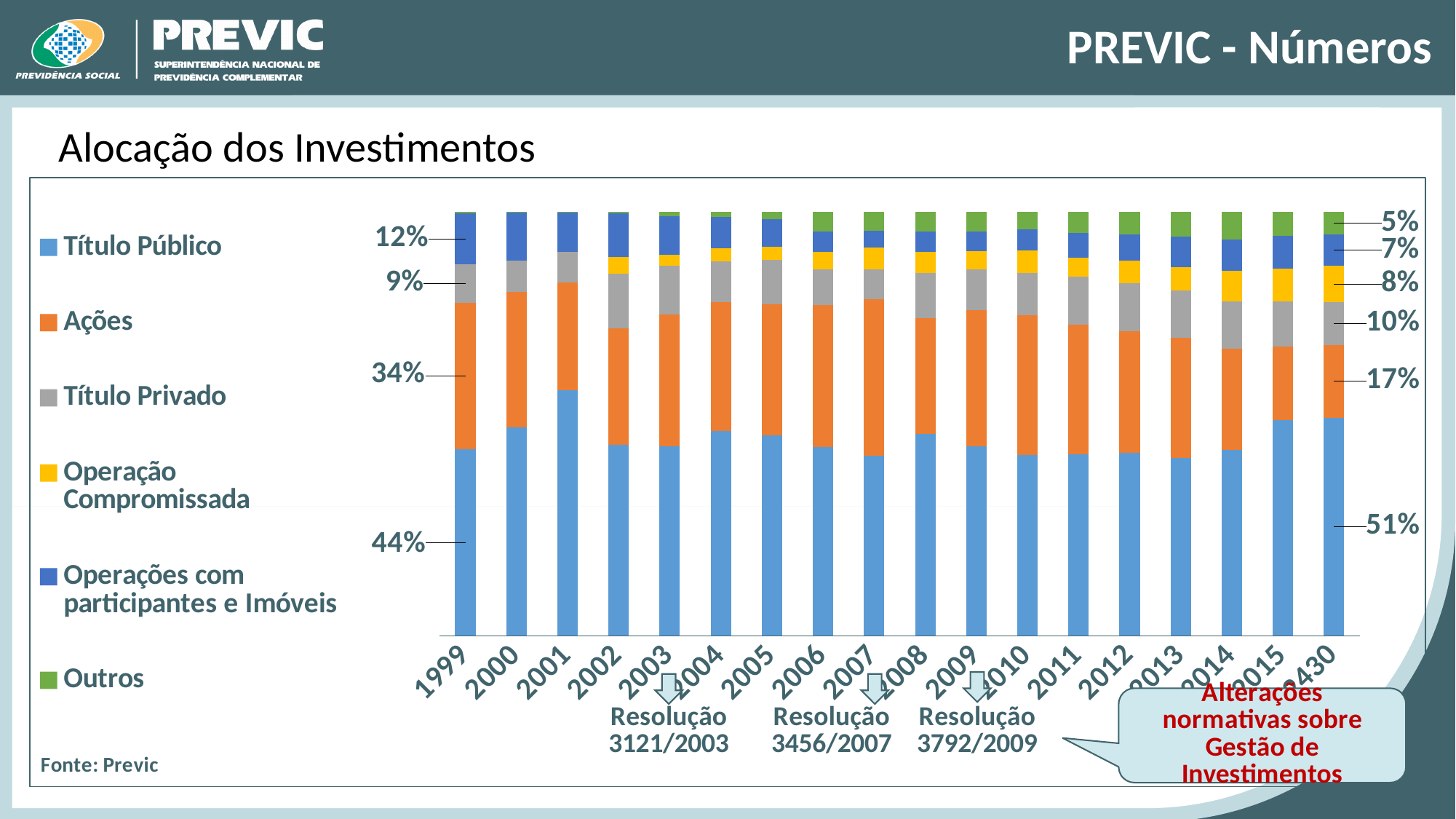
How many series does the legend list? 6 By how many percentage points is the Título Público share in the rightmost bar higher than in 1999? 7 percentage points What is the share of Título Privado in 1999? 9% What source is cited for the chart? Previc What is the share of Título Público in the rightmost bar? 51% Which is larger: the Ações share in 1999 or in the rightmost bar? 1999 What is the share of Ações in 1999? 34% What is the share of Título Público in 1999? 44% What is the share of Ações in the rightmost bar? 17% What is the share of Outros in the rightmost bar? 5% What kind of chart is shown on the slide? Stacked bar chart What is the share of Operações com participantes e Imóveis in 1999? 12%